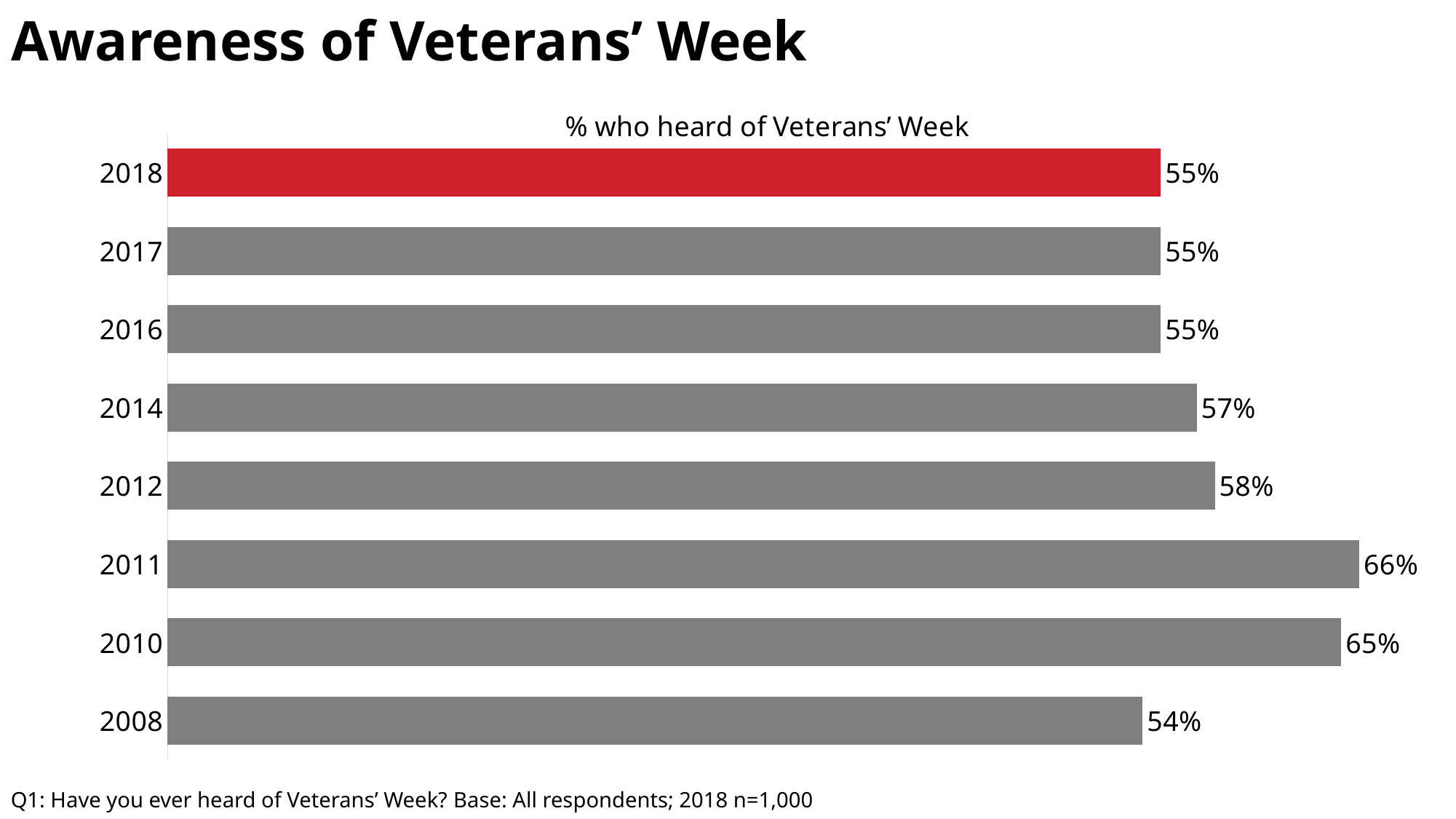
What percentage of respondents had heard of Veterans' Week in 2018? 55% Which year's bar is coloured red? 2018 How many years are shown in the chart? 8 What is the difference between the 2011 value and the 2018 value? 11% What is the difference between the 2010 value and the 2008 value? 11% Which year has a larger value, 2014 or 2010? 2010 Which year has the highest percentage who heard of Veterans' Week? 2011 Which year has the lowest percentage who heard of Veterans' Week? 2008 What kind of chart is shown on the slide? Bar chart What is the value shown for 2008? 54% What is the value shown for 2011? 66% What is the value shown for 2012? 58%